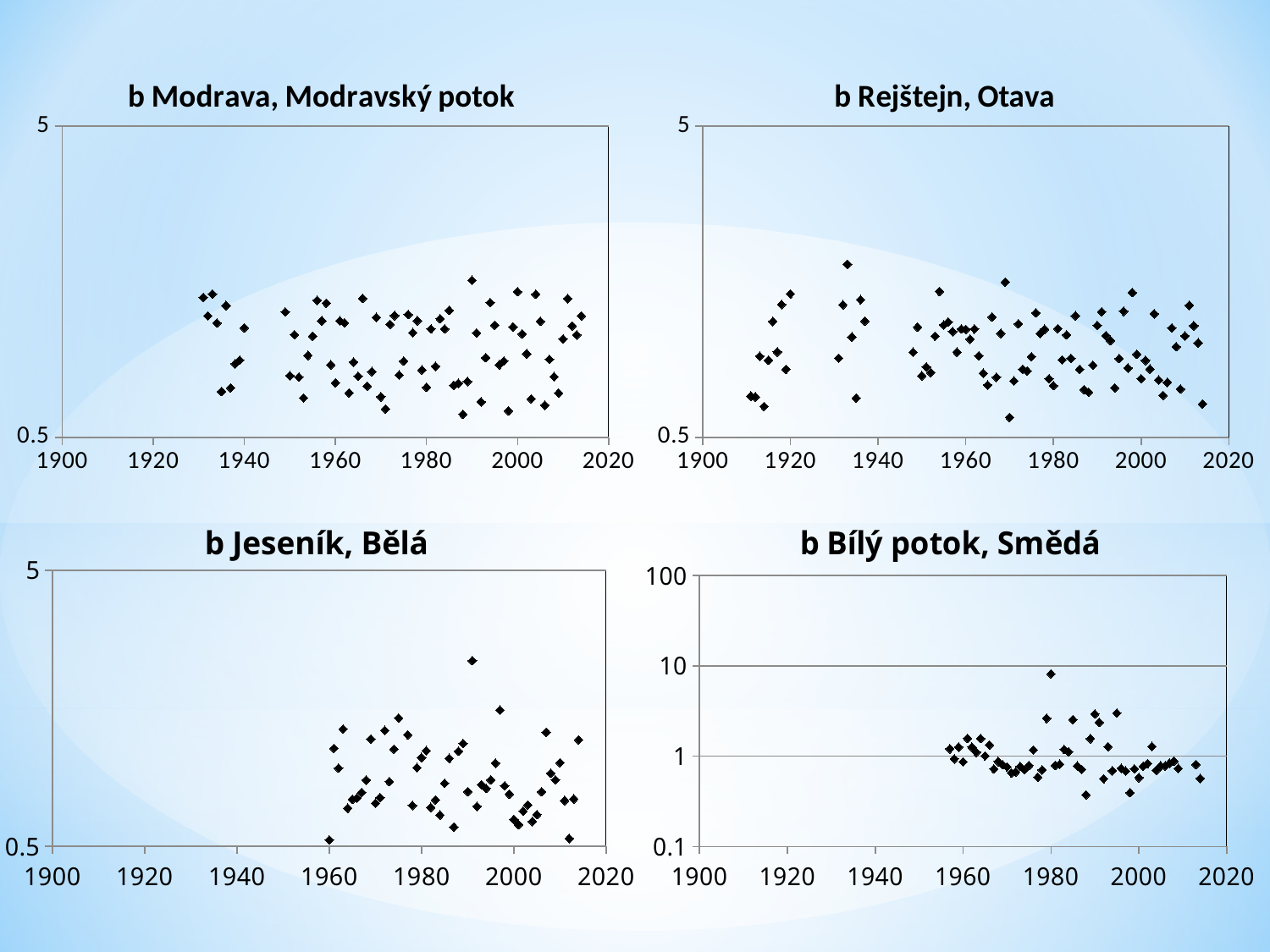
How many charts are shown on the slide? 4 In the "b Bílý potok, Smědá" chart, is the lowest point greater or less than 1? less Which chart on the slide contains data points from before 1920? b Rejštejn, Otava In the "b Bílý potok, Smědá" chart, is the highest point greater or less than 10? less In the "b Jeseník, Bělá" chart, is the highest point greater or less than 5? less What is the range of the x axis on the "b Modrava, Modravský potok" chart? 1900 to 2020 What kind of chart is "b Modrava, Modravský potok"? scatter chart Which chart on the slide has a y axis running from 0.1 to 100? b Bílý potok, Smědá